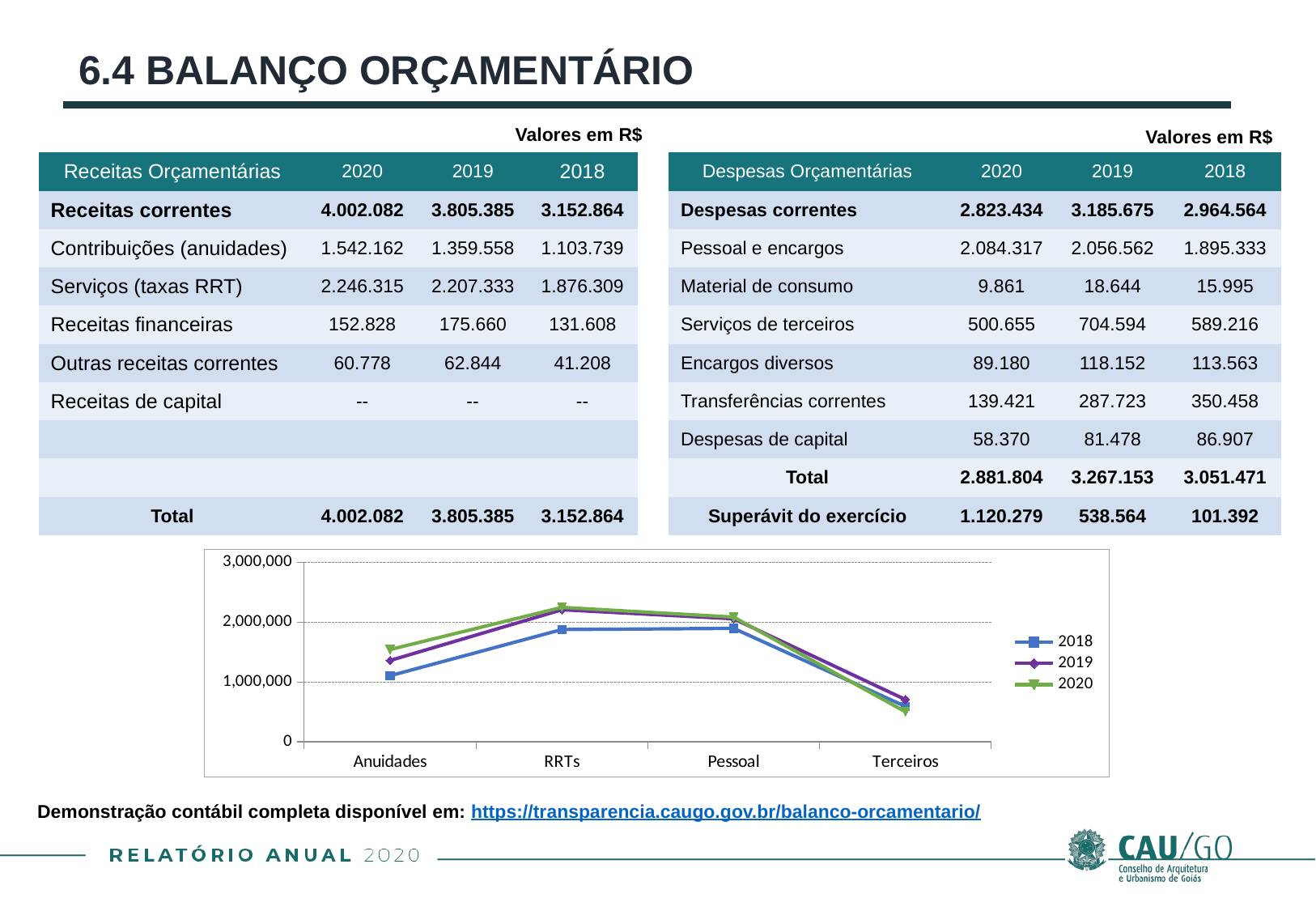
What kind of chart is shown at the bottom of the slide? line chart How many categories are shown on the x axis of the line chart? 4 In the line chart, do the values for the 2019 series rise or fall from Pessoal to Terceiros? fall In the line chart, is the 2018 value for RRTs greater or less than 2,000,000? less In the line chart, is the 2020 value for RRTs greater or less than 2,000,000? greater In the line chart, which is larger for Anuidades: the 2020 value or the 2018 value? 2020 In the line chart, which category has the highest value for the 2020 series? RRTs How many series does the legend of the line chart list? 3 In the line chart, which category has the lowest value for the 2020 series? Terceiros In the line chart, is the 2020 value for Terceiros greater or less than 1,000,000? less Which series in the line chart is drawn in green? 2020